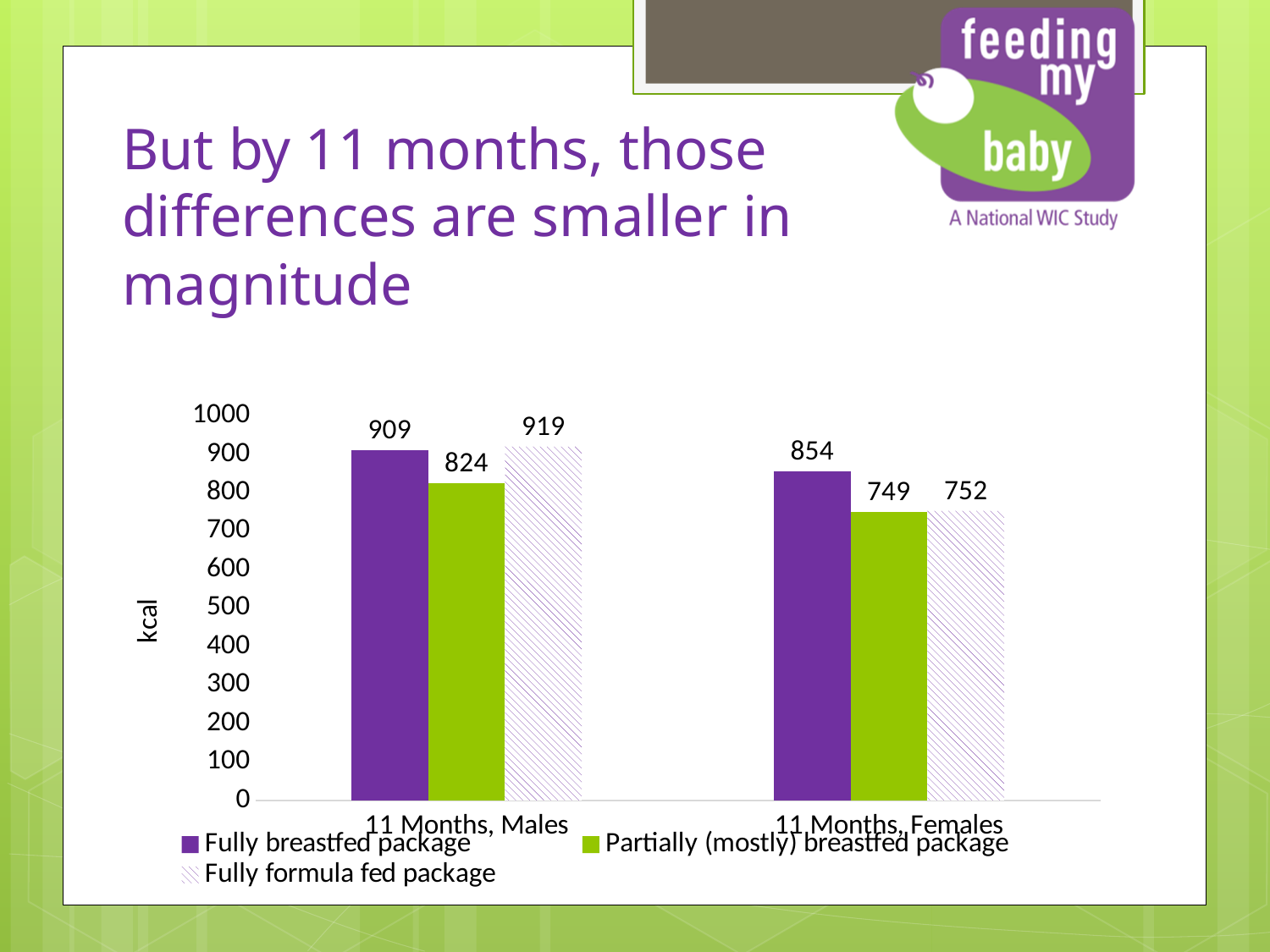
What is the value for the Fully breastfed package for 11 Months, Males? 909 What is the value for the Partially (mostly) breastfed package for 11 Months, Females? 749 What is the difference between the Fully breastfed package and the Partially (mostly) breastfed package for 11 Months, Males? 85 Which series has the highest value for 11 Months, Males? Fully formula fed package What is the difference between the Fully breastfed package values for 11 Months, Males and 11 Months, Females? 55 Which is larger: the Fully formula fed package value for 11 Months, Males or for 11 Months, Females? 11 Months, Males What is the value for the Fully formula fed package for 11 Months, Males? 919 What kind of chart is shown on the slide? Bar chart What is the value for the Fully breastfed package for 11 Months, Females? 854 Which series has the lowest value for 11 Months, Females? Partially (mostly) breastfed package How many series does the legend list? 3 What is the label on the vertical axis of the chart? kcal